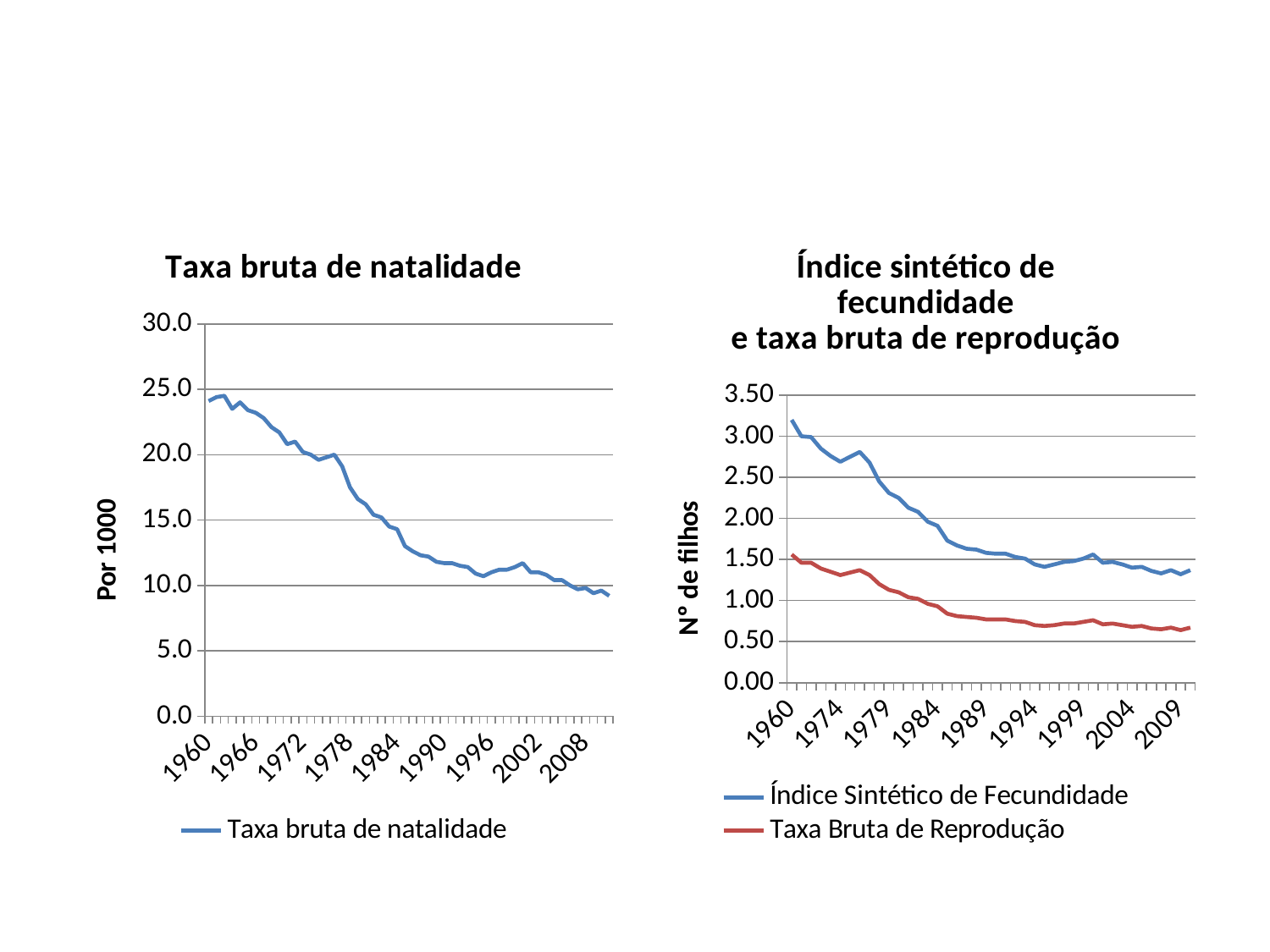
What is the y-axis label of the 'Taxa bruta de natalidade' chart? Por 1000 In the right-hand chart, does the 'Índice Sintético de Fecundidade' line rise or fall from 1960 to 2009? fall In the 'Taxa bruta de natalidade' chart, is the value for 1990 greater or less than 15.0? less In the right-hand chart, is the 'Taxa Bruta de Reprodução' value for 2009 greater or less than 1.00? less How many series does the legend of the 'Taxa bruta de natalidade' chart list? 1 What kind of chart is the 'Taxa bruta de natalidade' chart? line chart How many series does the legend of the right-hand chart list? 2 What kind of chart is the 'Índice sintético de fecundidade e taxa bruta de reprodução' chart? line chart In the right-hand chart, is the 'Índice Sintético de Fecundidade' value for 1960 greater or less than 3.00? greater In the right-hand chart, which series has the higher value in 1960, 'Índice Sintético de Fecundidade' or 'Taxa Bruta de Reprodução'? Índice Sintético de Fecundidade In the 'Taxa bruta de natalidade' chart, do the values rise or fall from 1960 to 2008? fall